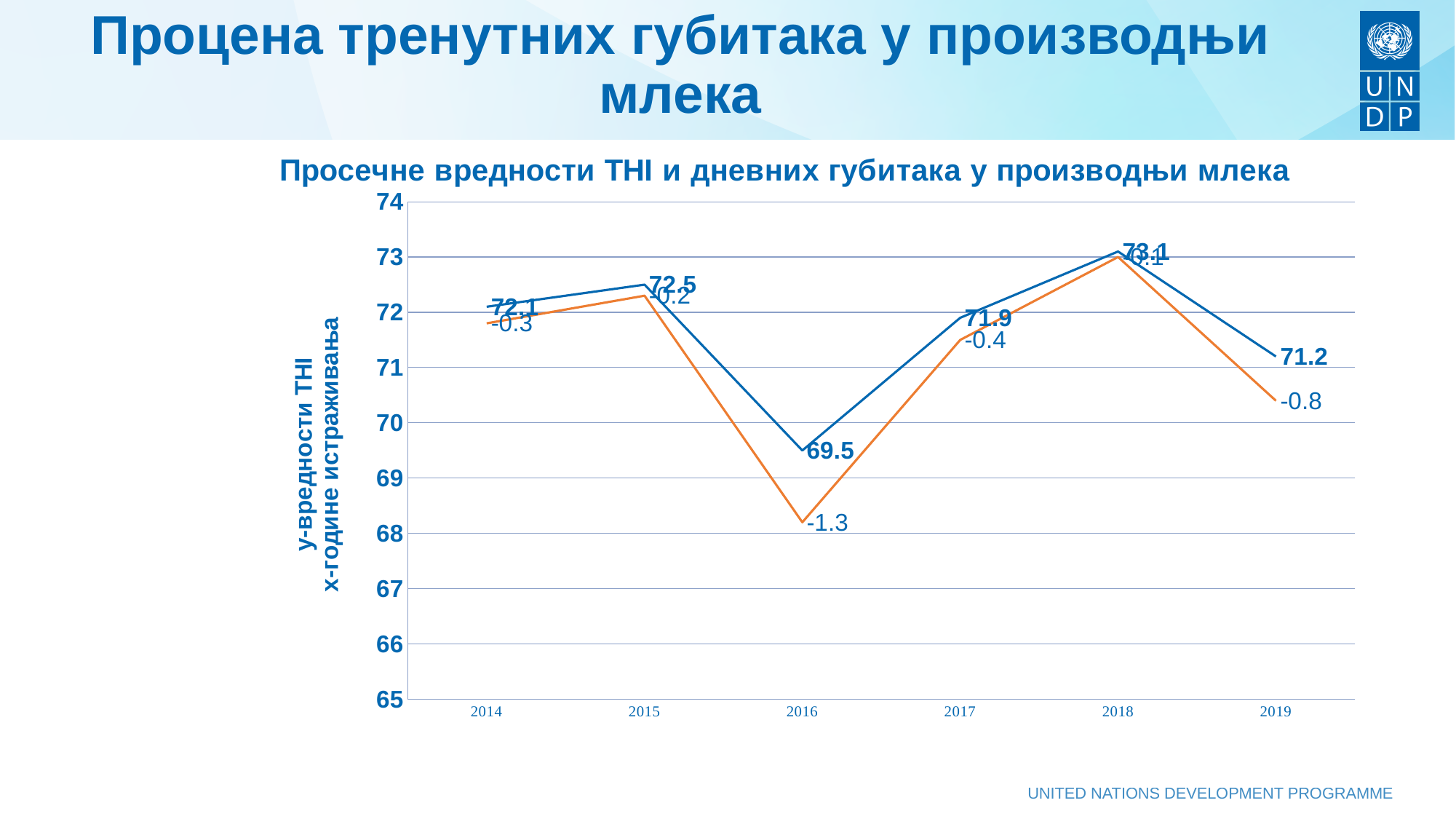
How many years are shown on the x axis? 6 What is the daily loss value (orange line) for 2019? -0.8 What kind of chart is shown on the slide? line chart What is the daily loss value (orange line) for 2016? -1.3 In which year is the THI value (blue line) lowest? 2016 Which year has the larger THI value, 2015 or 2017? 2015 What is the THI value (blue line) for 2019? 71.2 What is the difference between the THI values for 2018 and 2016? 3.6 Does the THI value (blue line) rise or fall from 2016 to 2018? rise What is the THI value (blue line) for 2016? 69.5 Is the THI value for 2016 greater or less than 70? less In which year is the THI value (blue line) highest? 2018